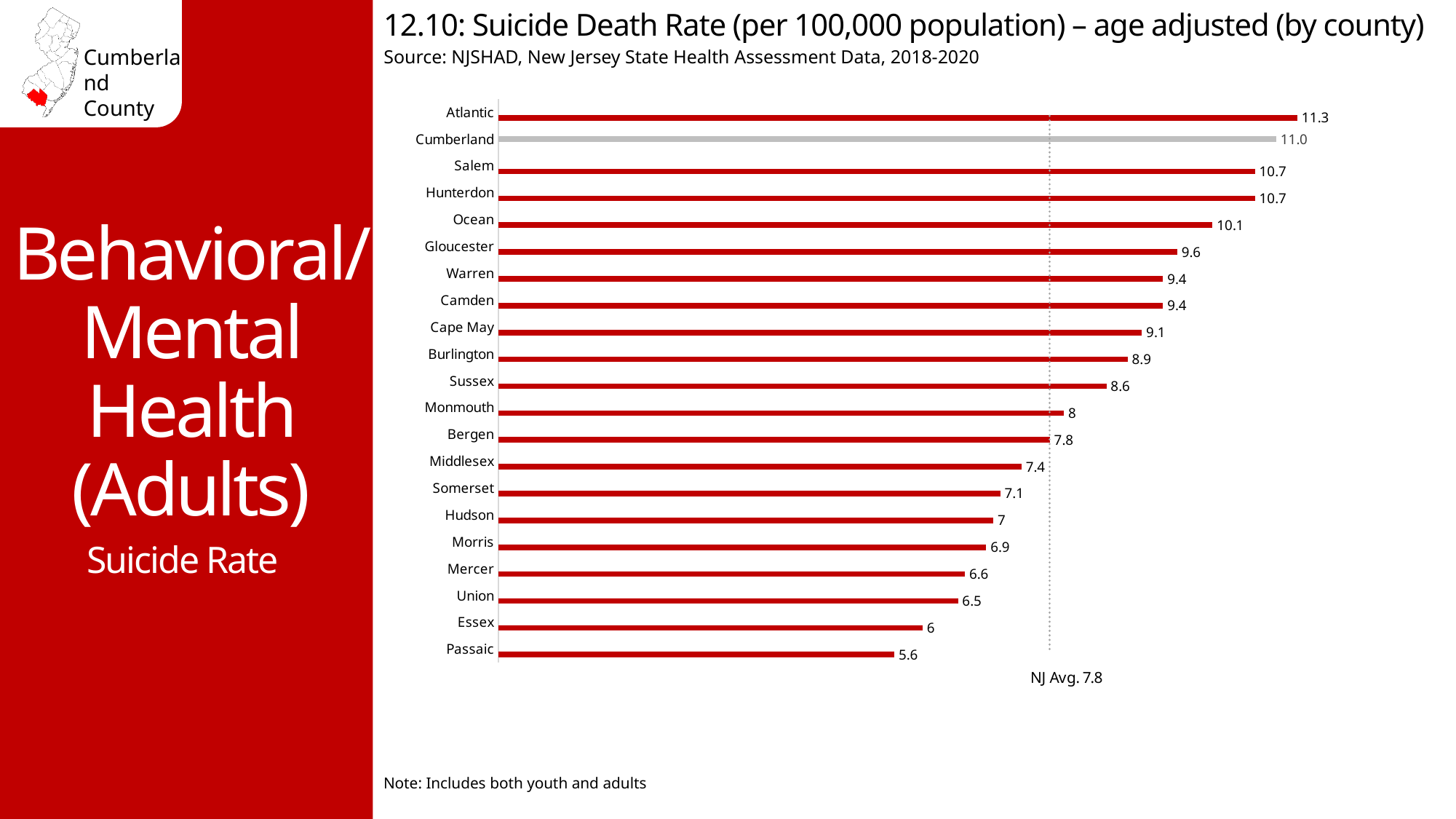
What is the difference between the suicide death rates of Atlantic and Cumberland counties? 0.3 What is the suicide death rate for Gloucester County? 9.6 What is the difference between the suicide death rates of Ocean and Passaic counties? 4.5 What is the suicide death rate for Cumberland County? 11.0 What is the NJ average suicide death rate marked by the dotted line? 7.8 Which county has the lowest suicide death rate? Passaic Which county has a higher suicide death rate, Sussex or Monmouth? Sussex Which county's bar is shown in gray rather than red? Cumberland What kind of chart is shown on the slide? Bar chart What is the suicide death rate for Passaic County? 5.6 Which county has the highest suicide death rate? Atlantic How many counties are shown in the chart? 21